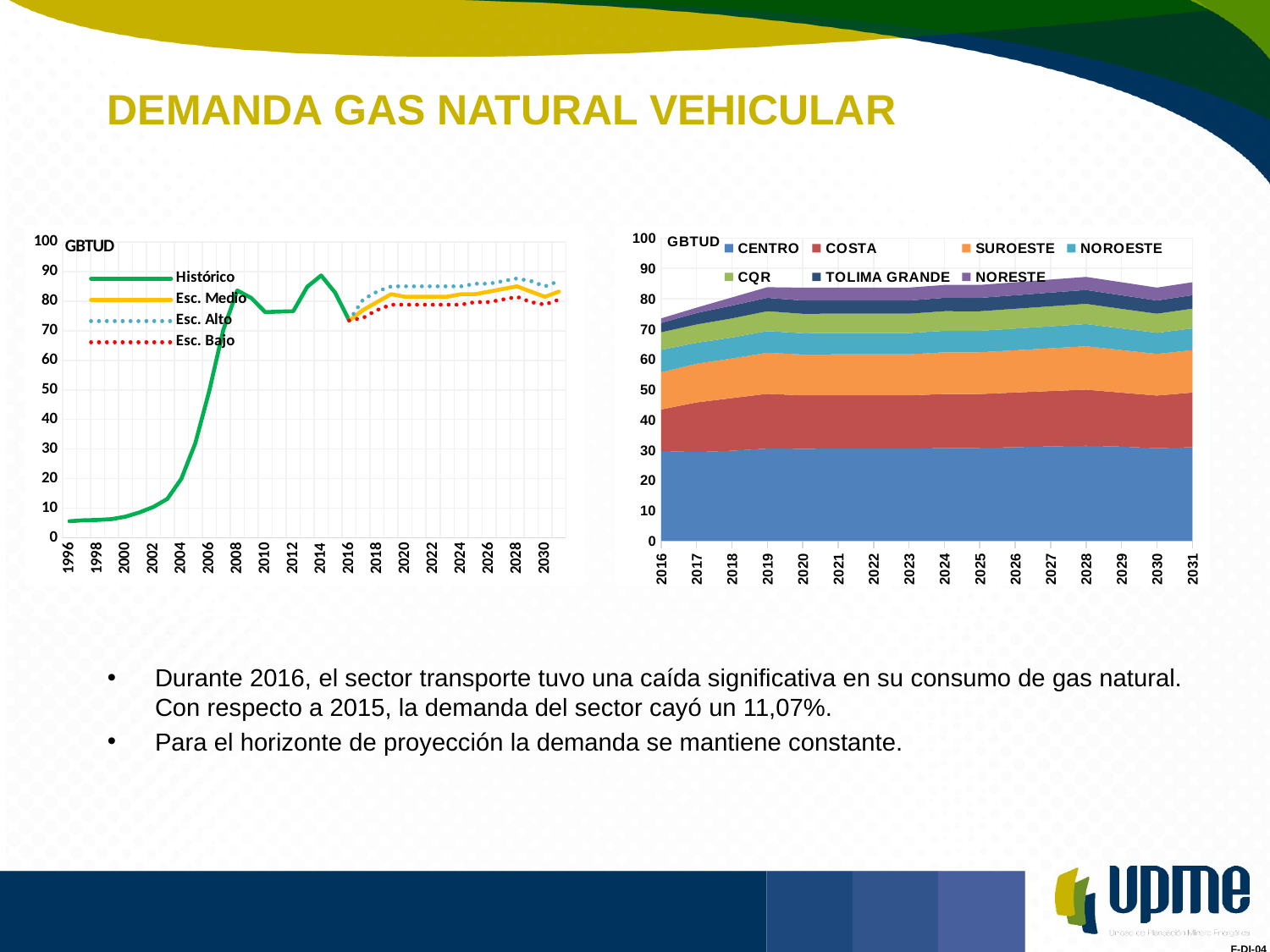
In the right chart, is the total stacked value for 2028 greater or less than 80? greater In the left chart, is the Esc. Alto value for 2030 greater or less than 80? greater In the left chart, is the Histórico value for 1996 greater or less than 10? less What kind of chart is the left chart on the slide? line chart What kind of chart is the right chart on the slide? stacked area chart How many series does the legend of the right chart list? 7 In the right chart, which series is plotted at the bottom of the stack? CENTRO In the left chart, does the Histórico series rise or fall between 1996 and 2008? rise How many series does the legend of the left chart list? 4